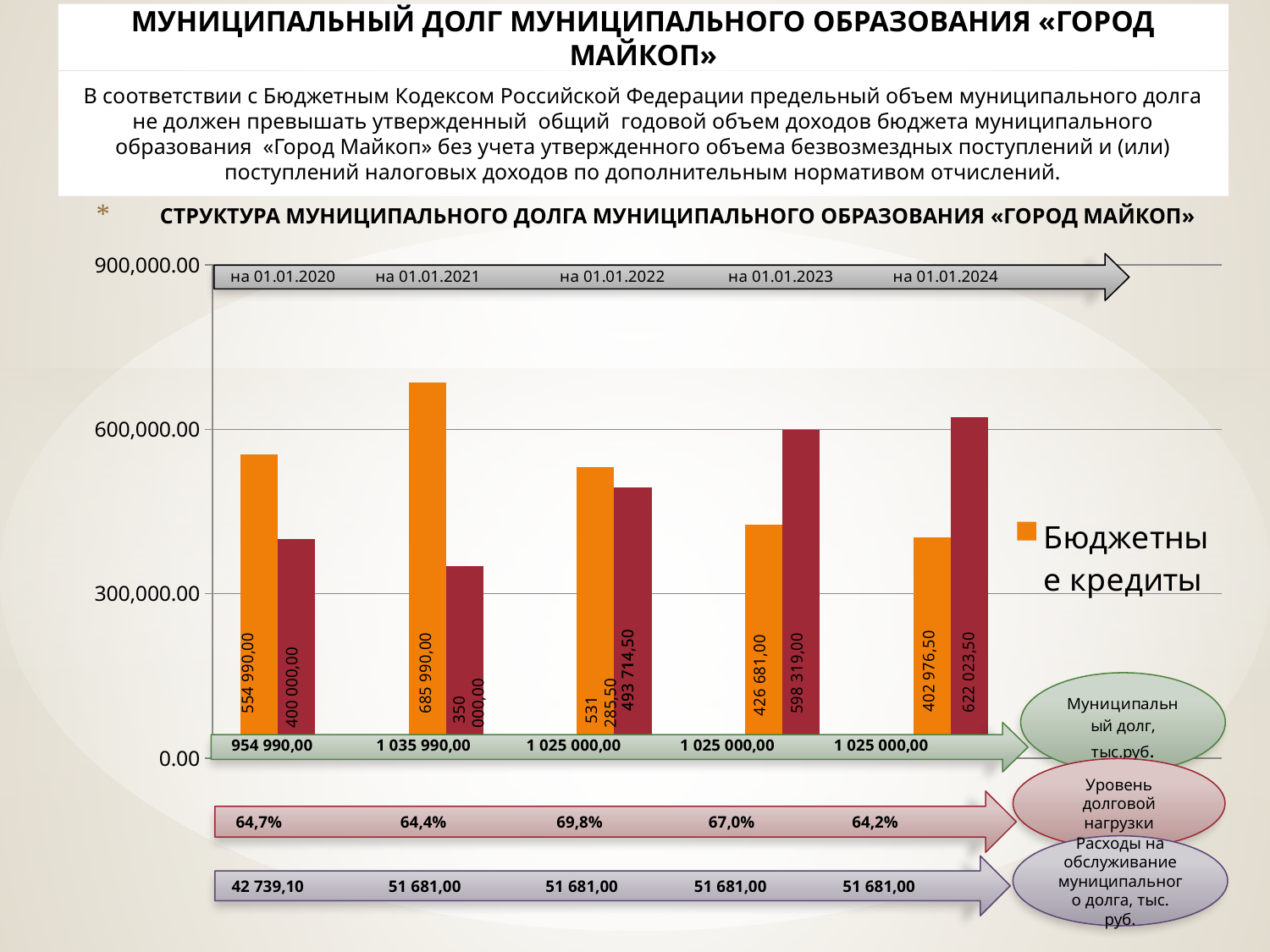
What kind of chart is used to show the structure of municipal debt? bar chart What is the total municipal debt (Муниципальный долг, тыс.руб.) shown for на 01.01.2021? 1 035 990,00 What is the value of Бюджетные кредиты на 01.01.2020? 554 990,00 Which is larger for Бюджетные кредиты: the value на 01.01.2022 or на 01.01.2023? на 01.01.2022 Do the values of Бюджетные кредиты rise or fall from на 01.01.2021 to на 01.01.2024? fall Is the value of Бюджетные кредиты на 01.01.2021 greater or less than 600,000.00? greater By how much does Бюджетные кредиты на 01.01.2021 exceed the value на 01.01.2020? 131 000,00 What is the value of Бюджетные кредиты на 01.01.2024? 402 976,50 What series name is shown in the chart legend? Бюджетные кредиты On which date is the value of Бюджетные кредиты the lowest? на 01.01.2024 On which date is the value of Бюджетные кредиты the highest? на 01.01.2021 How many dates (categories) are shown on the x axis of the chart? 5